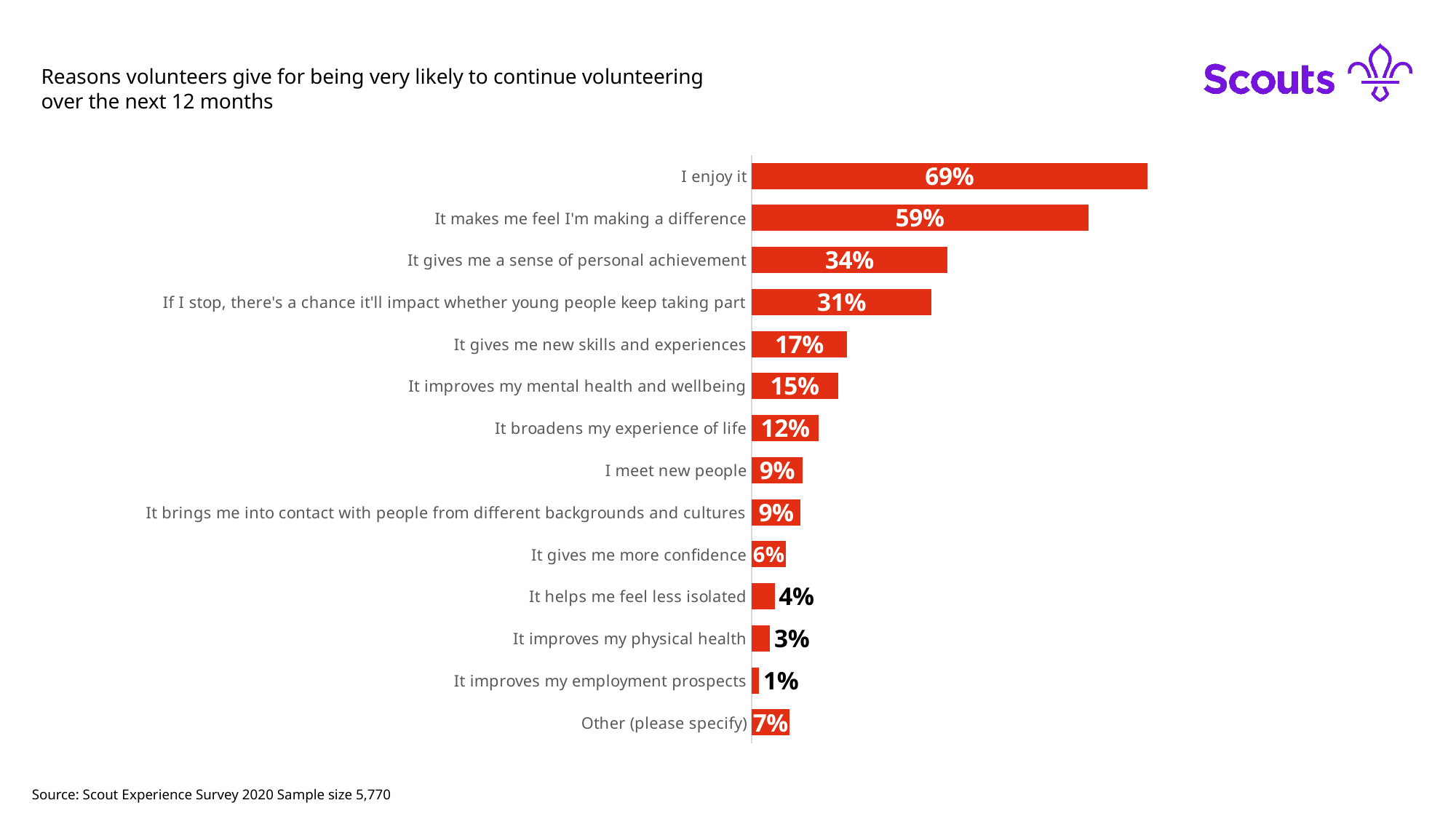
Which reason has the highest percentage? I enjoy it Which reason has the lowest percentage? It improves my employment prospects Which is larger: "It improves my mental health and wellbeing" or "It broadens my experience of life"? It improves my mental health and wellbeing What is the value for "It gives me new skills and experiences"? 17% What is the difference between "I enjoy it" and "It makes me feel I'm making a difference"? 10% What is the difference between "It gives me a sense of personal achievement" and "It gives me new skills and experiences"? 17% What is the value for "Other (please specify)"? 7% What percentage of volunteers gave "I enjoy it" as a reason for being very likely to continue volunteering? 69% What kind of chart is shown on the slide? Bar chart What is the title of the chart? Reasons volunteers give for being very likely to continue volunteering over the next 12 months What is the value for "It improves my employment prospects"? 1% How many reasons are shown in the chart? 14